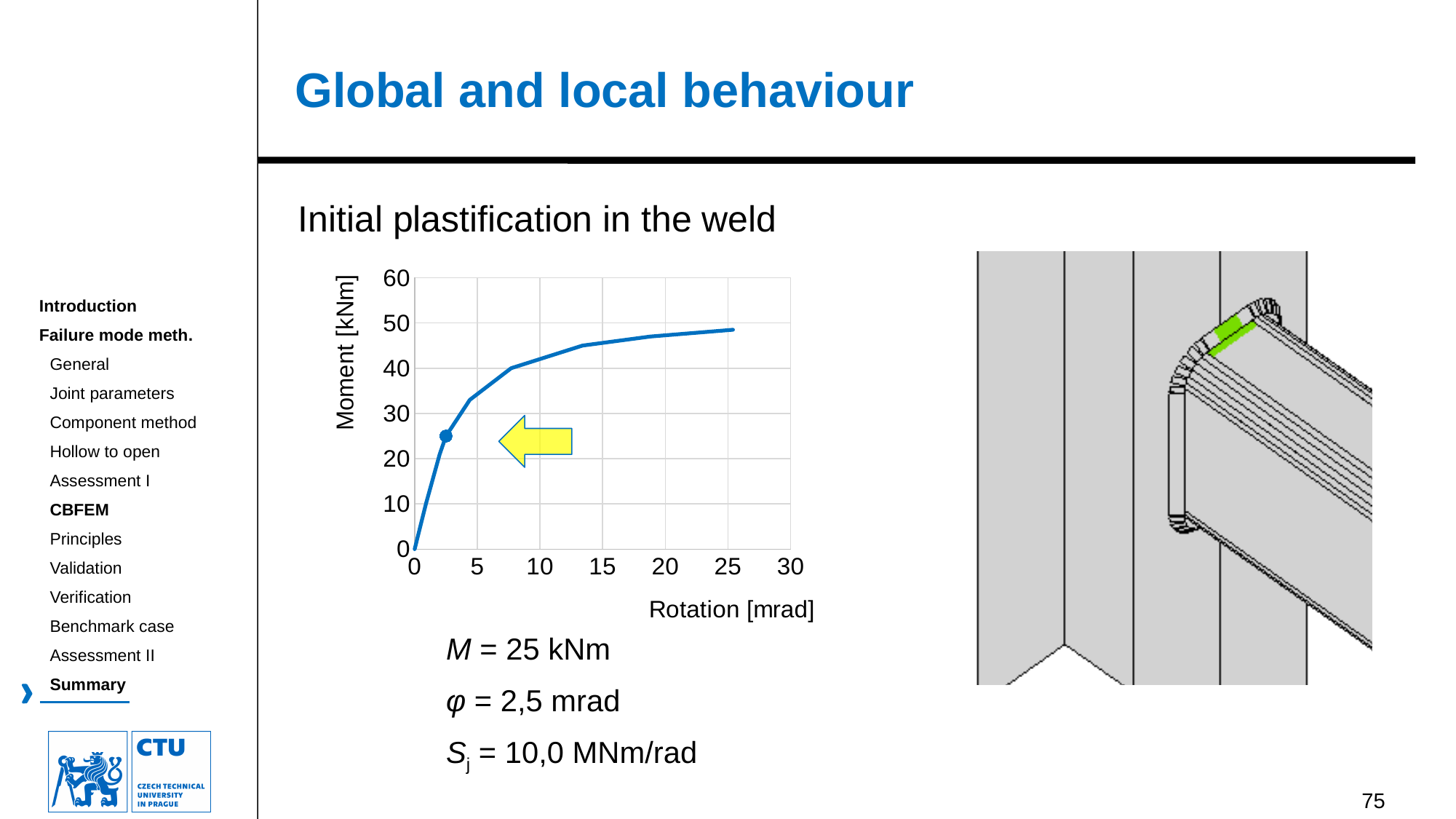
Does the moment rise or fall as rotation increases along the x axis? rise What is the moment M at the highlighted point on the curve? 25 kNm How many lines are plotted on the chart? 1 What is the label of the vertical axis of the chart? Moment [kNm] What is the rotation φ at the highlighted point on the curve? 2,5 mrad Is the moment at the highlighted point greater or less than 20 kNm? greater Is the moment at a rotation of 5 mrad greater or less than 40 kNm? less Is the moment at a rotation of 10 mrad greater or less than 30 kNm? greater What kind of chart is shown on the slide? line chart What is the label of the horizontal axis of the chart? Rotation [mrad]